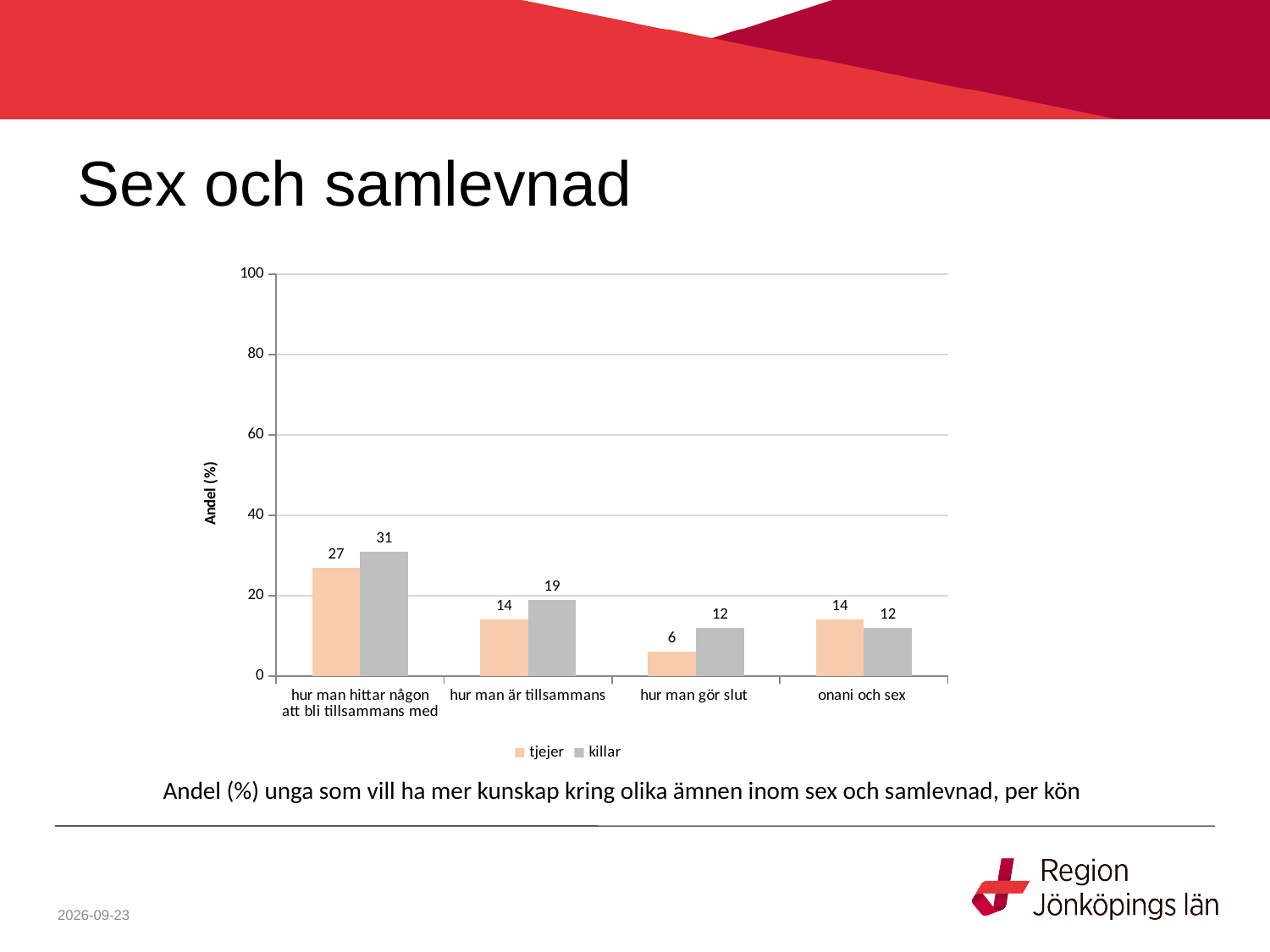
What kind of chart is shown on the slide? bar chart Is the value for killar in 'hur man hittar någon att bli tillsammans med' greater or less than 40? less What is the value for tjejer in the category 'hur man hittar någon att bli tillsammans med'? 27 In the category 'onani och sex', which series has the larger value, tjejer or killar? tjejer Which category has the highest value for killar? hur man hittar någon att bli tillsammans med Which category has the lowest value for tjejer? hur man gör slut How many categories are shown on the x axis? 4 What is the value for killar in the category 'hur man är tillsammans'? 19 What is the value for tjejer in the category 'hur man gör slut'? 6 What is the difference between killar and tjejer in the category 'hur man gör slut'? 6 What is the label of the y axis? Andel (%) How many series does the legend list? 2